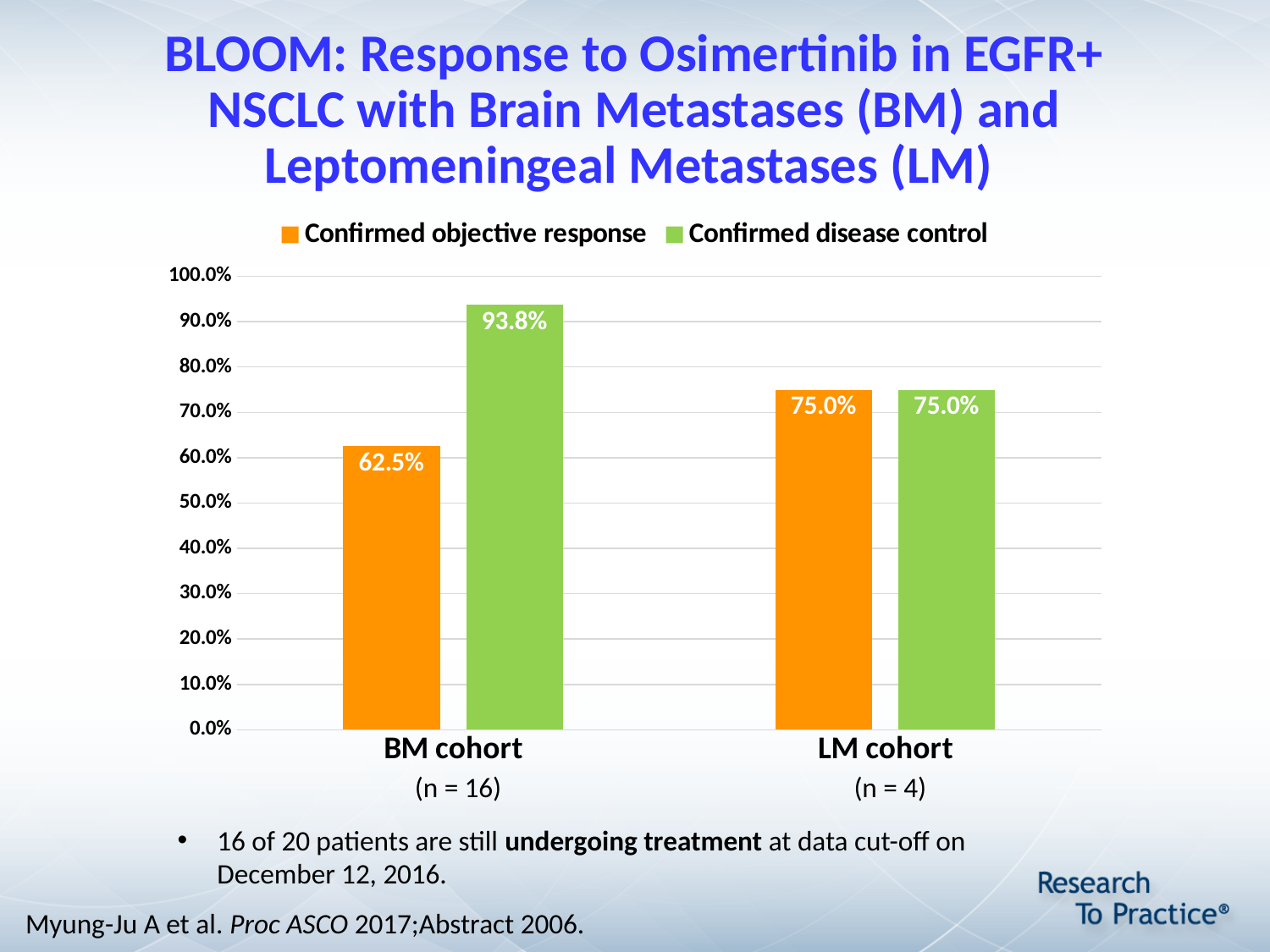
What is the confirmed disease control rate for the LM cohort? 75.0% What is the confirmed objective response rate for the BM cohort? 62.5% Is the confirmed objective response rate higher in the BM cohort or the LM cohort? LM cohort What is the difference between the confirmed disease control rate and the confirmed objective response rate in the BM cohort? 31.3% How many series does the legend list? 2 What is the confirmed objective response rate for the LM cohort? 75.0% Which cohort has the higher confirmed disease control rate? BM cohort How many cohorts are shown on the x axis? 2 Is the confirmed disease control rate for the BM cohort greater or less than 90.0%? greater What is the confirmed disease control rate for the BM cohort? 93.8% What kind of chart is shown on the slide? Bar chart Which cohort has the lower confirmed objective response rate? BM cohort